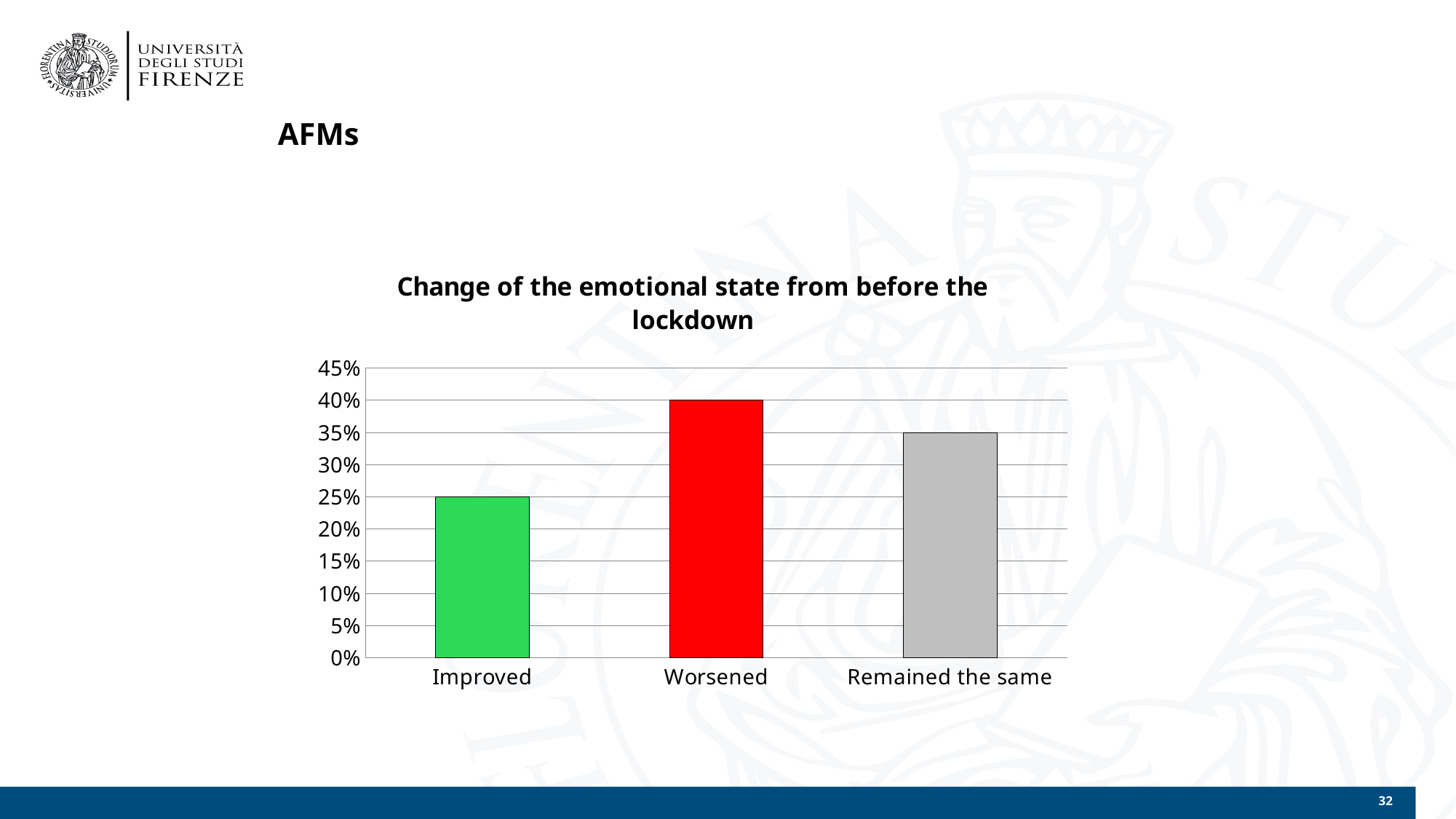
What is the value for Improved? 25% Which category has the lowest value? Improved How many categories are shown on the x axis of the chart? 3 What is the difference between the values for Worsened and Improved? 15% What is the value for Worsened? 40% Which category has the highest value? Worsened What is the title of the chart? Change of the emotional state from before the lockdown What colour is the bar for Worsened? red What is the value for Remained the same? 35% Is the value for Improved greater or less than 30%? less What type of chart is shown on the slide? bar chart Which is larger, the value for Worsened or the value for Remained the same? Worsened